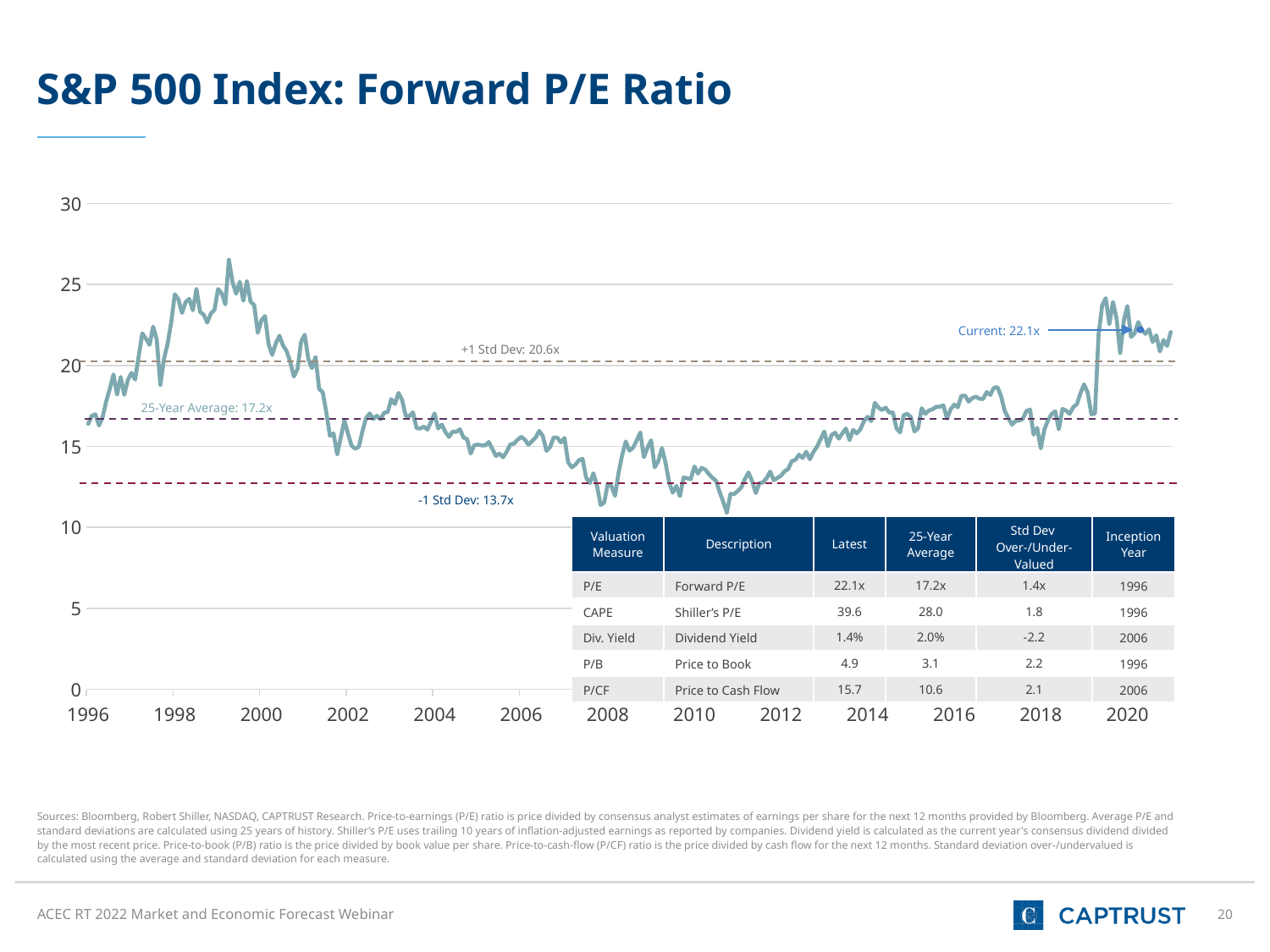
What is the title of the chart on the slide? S&P 500 Index: Forward P/E Ratio What kind of chart is used to show the S&P 500 forward P/E ratio? line chart What is the current forward P/E ratio labeled on the chart? 22.1x By how much does the current forward P/E (22.1x) exceed the 25-year average (17.2x)? 4.9x Is the peak forward P/E value around 1999 greater or less than 25? greater Did the forward P/E ratio rise or fall between 2000 and 2002? fall What value is labeled for the -1 standard deviation line? 13.7x What is the difference between the +1 Std Dev line (20.6x) and the -1 Std Dev line (13.7x)? 6.9x What is the 25-year average forward P/E ratio shown on the chart? 17.2x Is the current forward P/E value larger or smaller than the +1 Std Dev level? larger What value is labeled for the +1 standard deviation line? 20.6x Is the forward P/E value at its low point around 2011 greater or less than 15? less